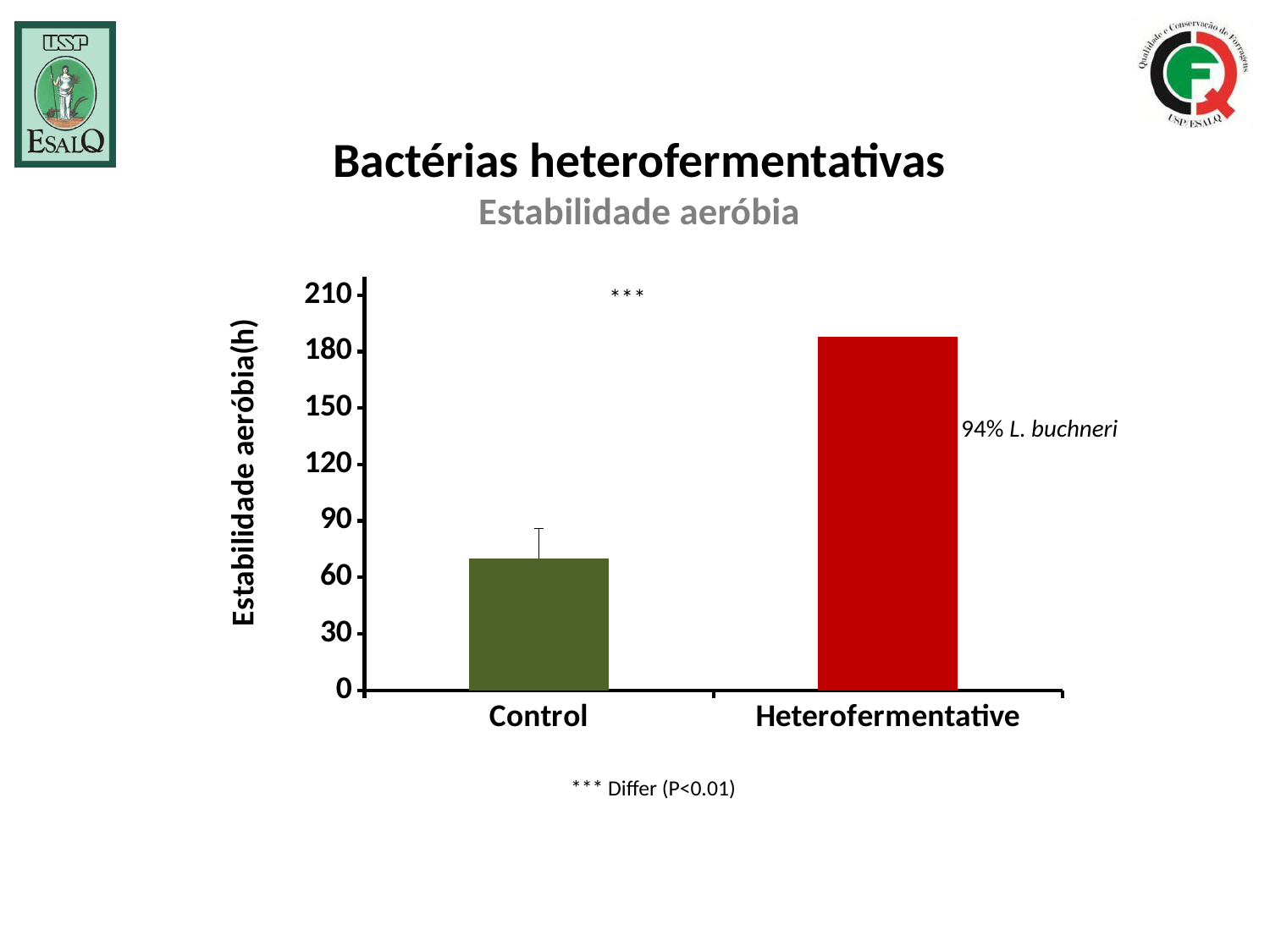
What is the label of the y axis of the chart? Estabilidade aeróbia(h) What kind of chart is shown on the slide? bar chart Is the value for Heterofermentative greater or less than 210? less Which bar is taller, Control or Heterofermentative? Heterofermentative Is the value for Heterofermentative greater or less than 150? greater Is the value for Control greater or less than 60? greater Which category has the highest aerobic stability in the chart? Heterofermentative What annotation is written next to the Heterofermentative bar? 94% L. buchneri Which category has the lowest aerobic stability in the chart? Control How many categories are plotted on the x axis of the chart? 2